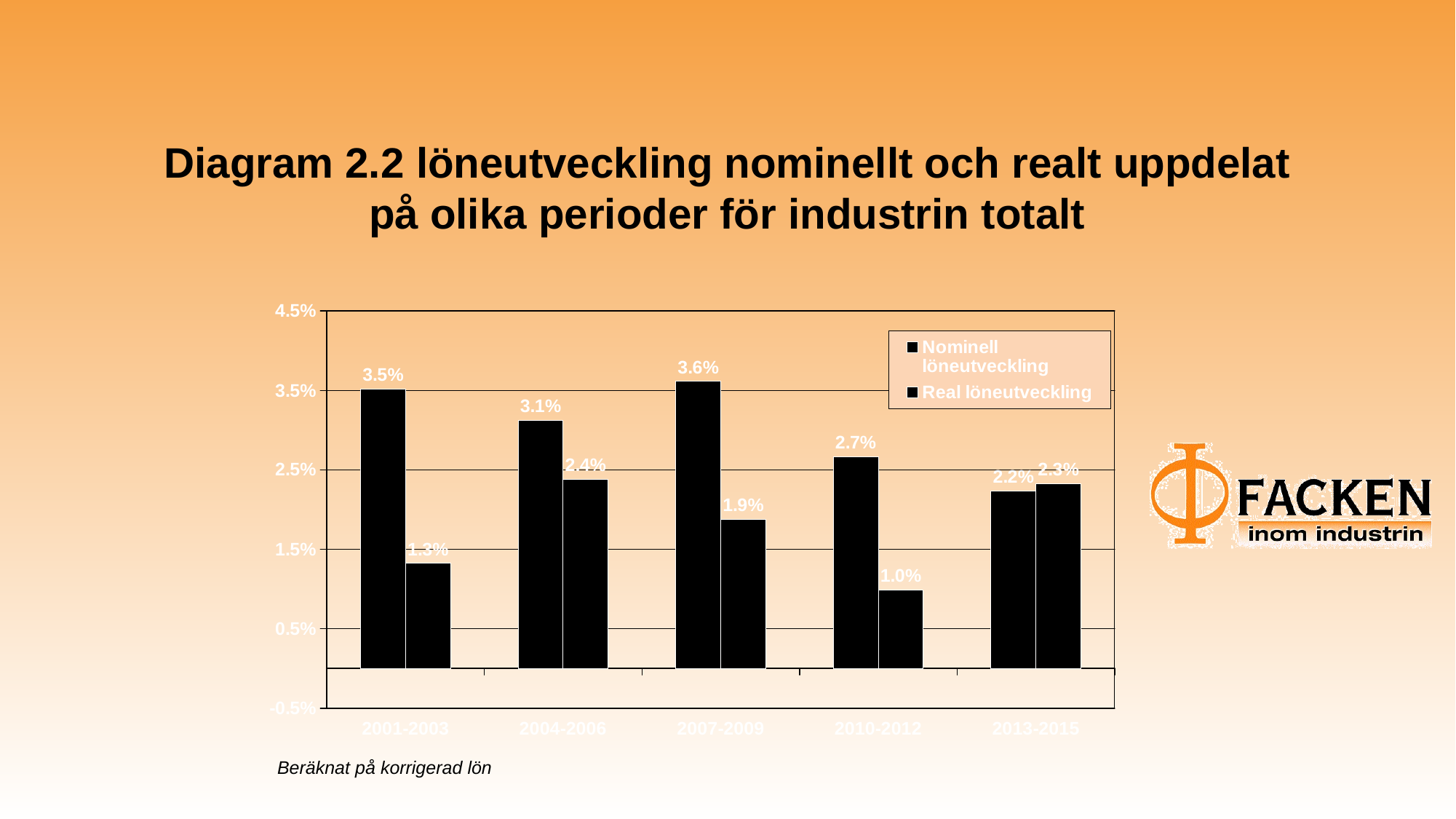
What is the Real löneutveckling value for 2010-2012? 1.0% Which period has the lowest Real löneutveckling? 2010-2012 How many periods are shown on the x axis? 5 What kind of chart is shown on the slide? Bar chart For 2013-2015, which is larger: Nominell löneutveckling or Real löneutveckling? Real löneutveckling Which period has the highest Nominell löneutveckling? 2007-2009 What is the Nominell löneutveckling value for 2007-2009? 3.6% What is the difference between Nominell and Real löneutveckling for 2001-2003? 2.2% What note is printed below the chart? Beräknat på korrigerad lön How many series does the legend list? 2 Does the Nominell löneutveckling value rise or fall from 2007-2009 to 2013-2015? Fall What is the Real löneutveckling value for 2004-2006? 2.4%